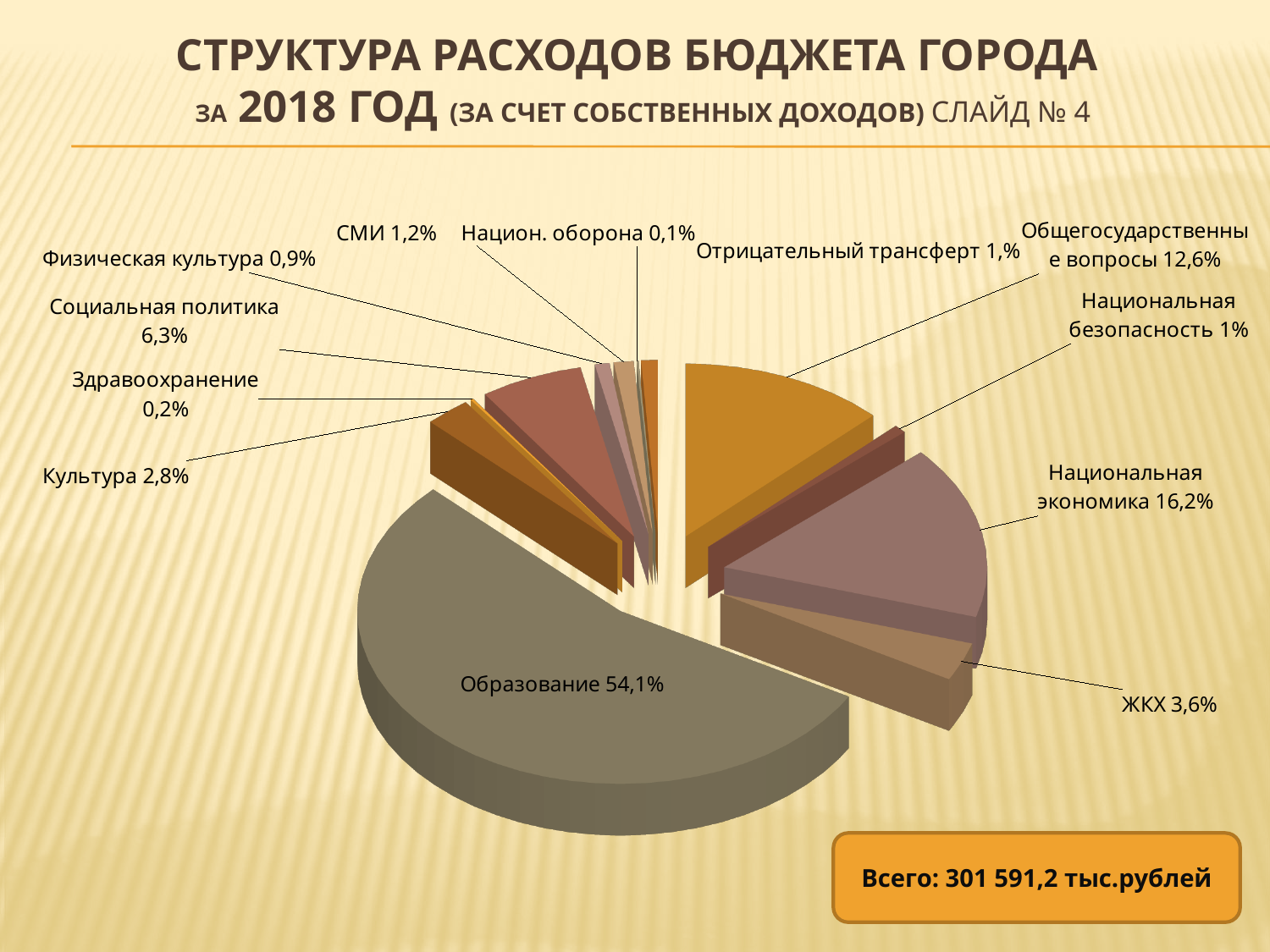
What share is shown for Национальная экономика? 16,2% What total amount is stated in the box at the bottom right of the slide? 301 591,2 тыс.рублей What share of the budget expenditure goes to Образование? 54,1% What share is shown for Общегосударственные вопросы? 12,6% Which is larger, the share for ЖКХ or the share for Культура? ЖКХ What is the difference in percentage points between Национальная экономика and Общегосударственные вопросы? 3,6 What share is shown for Социальная политика? 6,3% What kind of chart is shown on the slide? pie chart What share is shown for Здравоохранение? 0,2% How many categories are shown in the pie chart? 12 Which category has the smallest share of the pie? Национ. оборона Which category has the largest share of the pie? Образование